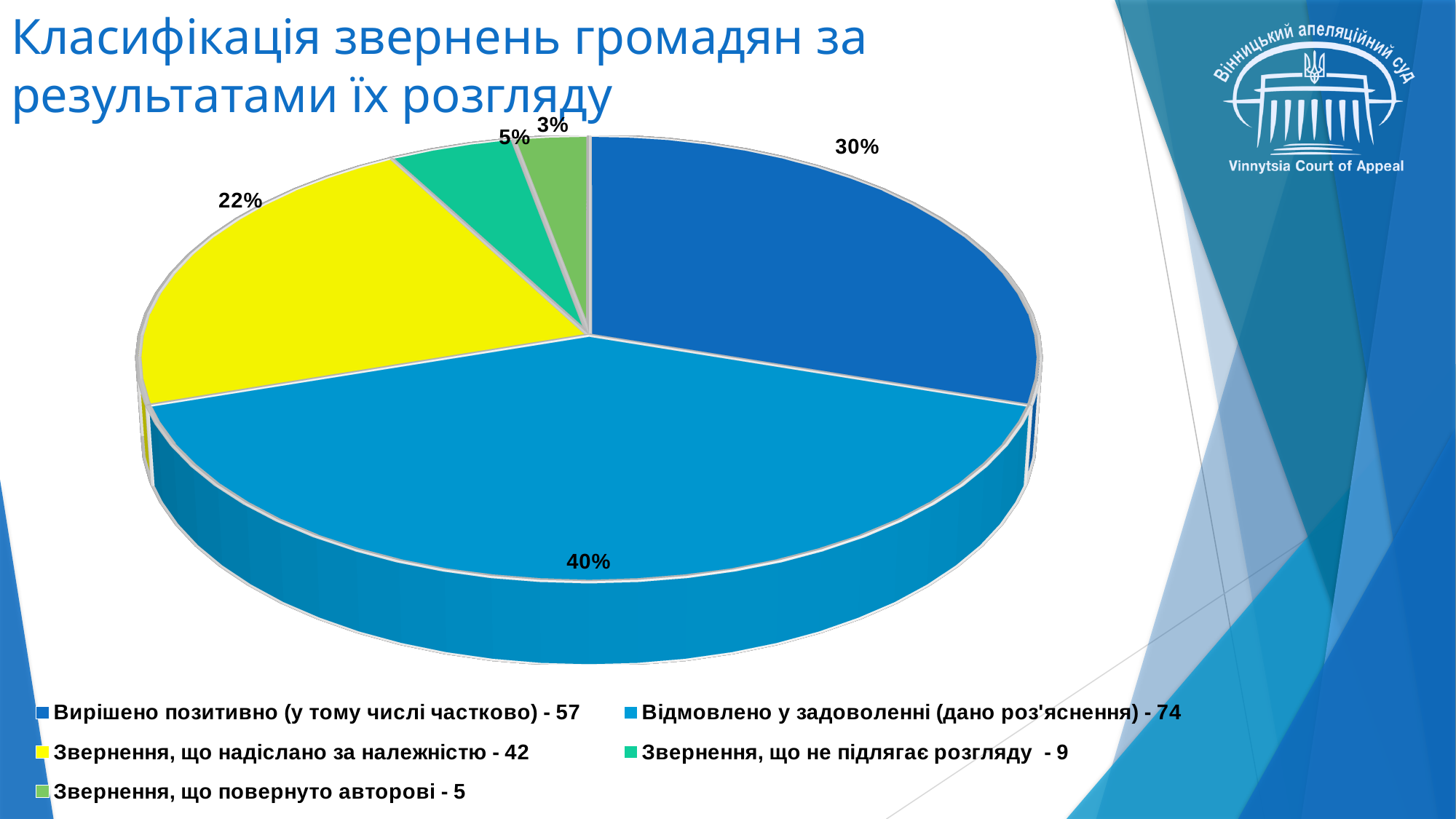
Which slice is larger: "Звернення, що надіслано за належністю" or "Звернення, що не підлягає розгляду"? Звернення, що надіслано за належністю What is the difference in percentage points between the "Відмовлено у задоволенні" slice and the "Вирішено позитивно" slice? 10 percentage points How many slices does the pie chart have? 5 What kind of chart is shown on the slide? pie chart Which category has the largest slice of the pie? Відмовлено у задоволенні (дано роз'яснення) What percentage share is shown for the slice "Вирішено позитивно (у тому числі частково)"? 30% Which category has the smallest slice of the pie? Звернення, що повернуто авторові According to the legend, how many appeals are in the category "Звернення, що не підлягає розгляду"? 9 What colour is the slice for "Звернення, що надіслано за належністю"? yellow What percentage share is shown for the slice "Звернення, що повернуто авторові"? 3% What percentage share is shown for the slice "Звернення, що надіслано за належністю"? 22%